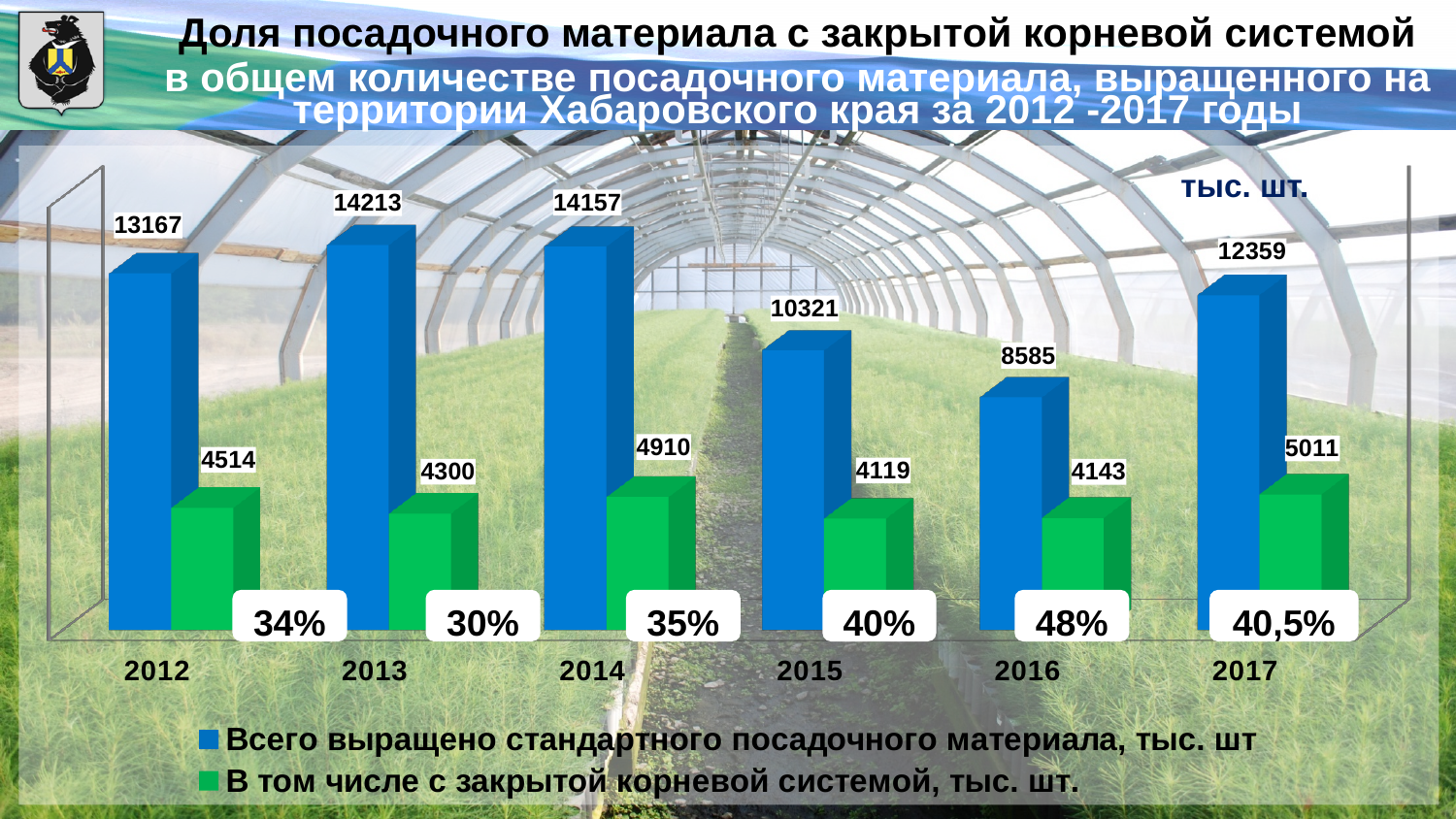
What kind of chart is shown on the slide? Bar chart What percentage is shown for 2016? 48% What is the value of "В том числе с закрытой корневой системой, тыс. шт." for 2017? 5011 What is the difference between the total planting material values for 2012 and 2015? 2846 How many years are shown on the x axis? 6 Which colour represents "В том числе с закрытой корневой системой, тыс. шт." in the legend? Green What is the value of "Всего выращено стандартного посадочного материала, тыс. шт" for 2016? 8585 Which year has the highest value for "Всего выращено стандартного посадочного материала, тыс. шт"? 2013 Which year has the lowest value for "В том числе с закрытой корневой системой, тыс. шт."? 2015 What is the value of "Всего выращено стандартного посадочного материала, тыс. шт" for 2013? 14213 Which is larger: the closed-root-system value for 2014 or for 2013? 2014 How many series does the legend list? 2